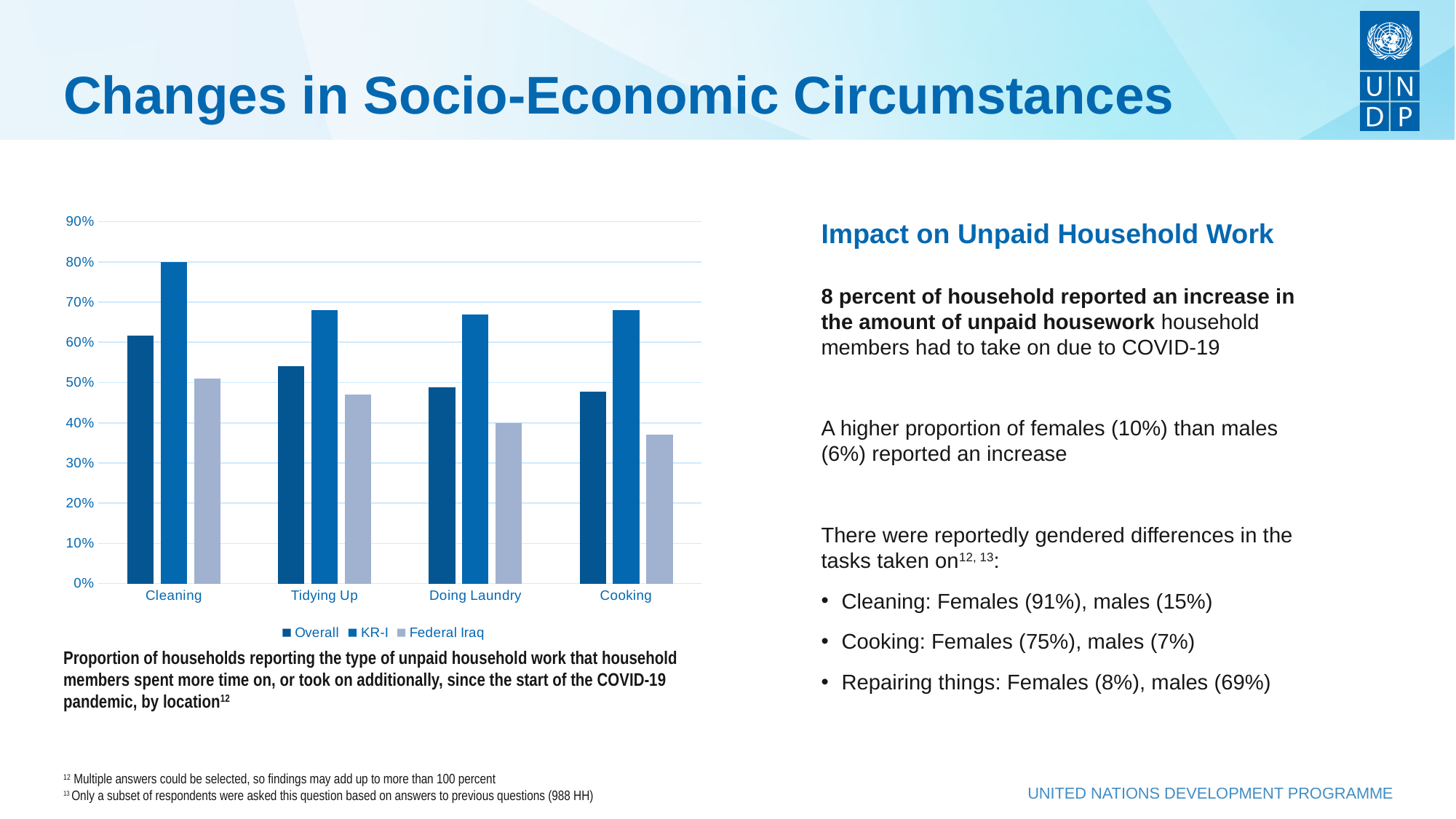
Is the KR-I value for Tidying Up greater or less than 60%? greater What is the KR-I value for Cleaning? 80% Is the Overall value for Cleaning greater or less than 60%? greater What kind of chart is shown on the slide? bar chart Which is larger, the Overall value for Cleaning or the Overall value for Cooking? Cleaning Which category has the highest KR-I value? Cleaning How many series does the chart legend list? 3 Do the Overall values rise or fall moving from Cleaning to Cooking along the x axis? fall Is the Federal Iraq value for Cooking greater or less than 40%? less How many categories of household work are shown on the x axis? 4 What are the three series listed in the chart legend? Overall, KR-I, Federal Iraq Which category has the lowest Federal Iraq value? Cooking